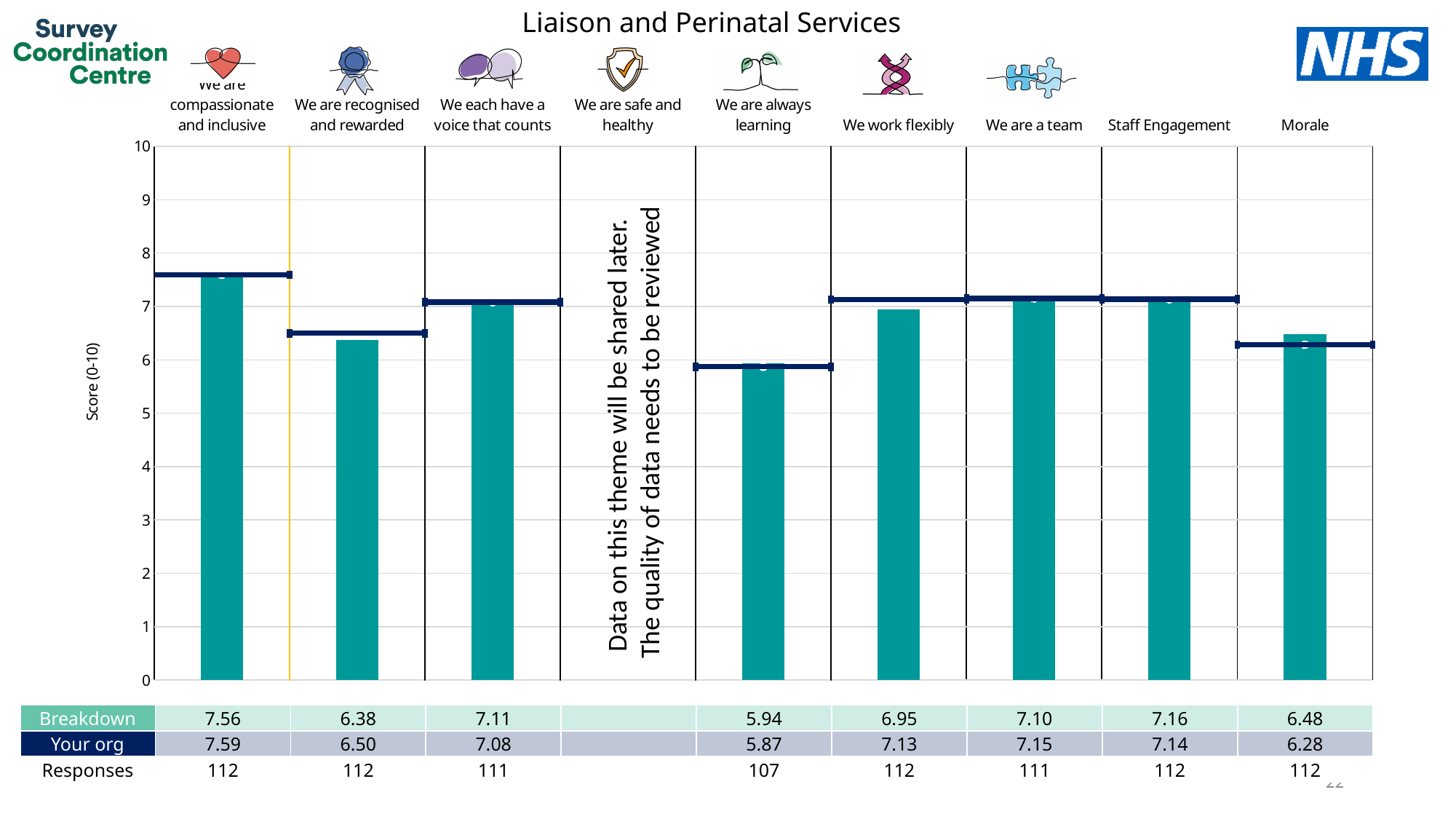
Is the Breakdown score for 'We are always learning' greater or less than 6? less What kind of chart is shown on the slide? bar chart What is the Breakdown score for 'We are compassionate and inclusive'? 7.56 What is the Your org score for 'We work flexibly'? 7.13 Which theme has the lowest Breakdown score? We are always learning Which theme has the highest Breakdown score? We are compassionate and inclusive Which theme has no data plotted on the chart? We are safe and healthy How many responses are recorded for 'We are always learning'? 107 How many themes have a Breakdown bar plotted on the chart? 8 What is the title of the chart? Liaison and Perinatal Services For 'We are recognised and rewarded', which is larger: the Breakdown score or the Your org score? Your org What is the difference between the Breakdown and Your org scores for Morale? 0.20